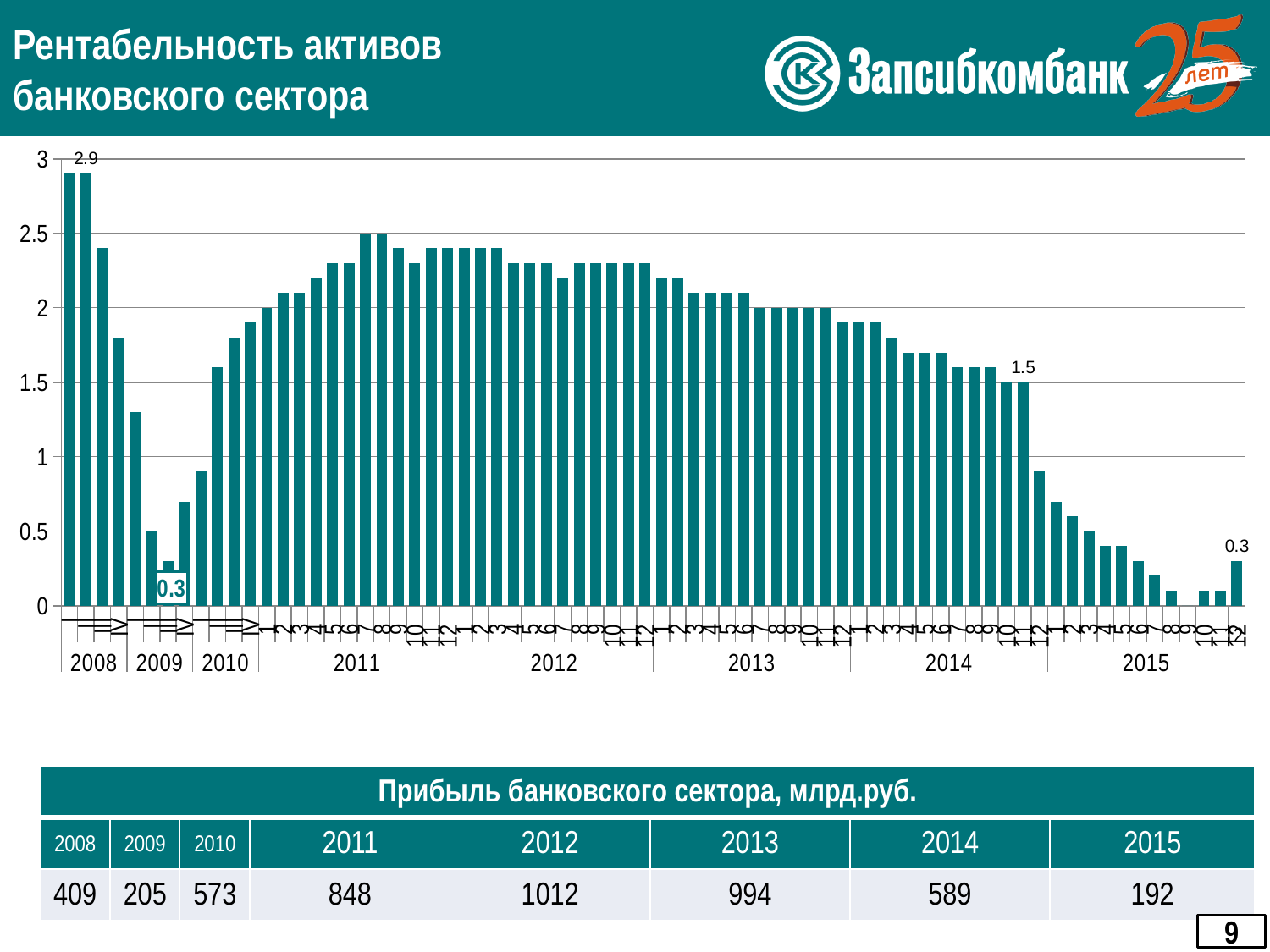
Do the values rise or fall along the x axis from 2014 through 2015? fall What kind of chart is shown on the slide? bar chart Are the values for the months of 2012 greater or less than 2? greater What is the lowest value labeled in the 2009 section of the chart? 0.3 What value is labeled on the bar in 2014 where the data label appears? 1.5 How many year groups are shown on the x axis of the chart? 8 What value is labeled on the first bar of the chart (start of 2008)? 2.9 What is the difference between the labeled value at the start of 2008 (2.9) and the labeled value at the end of 2015 (0.3)? 2.6 Which is larger: the labeled value in 2014 (1.5) or the labeled value at the end of 2015 (0.3)? 1.5 (2014) What is the title of the chart on the slide? Рентабельность активов банковского сектора What value is labeled on the last bar of the chart (end of 2015)? 0.3 What is the highest value labeled on the chart? 2.9